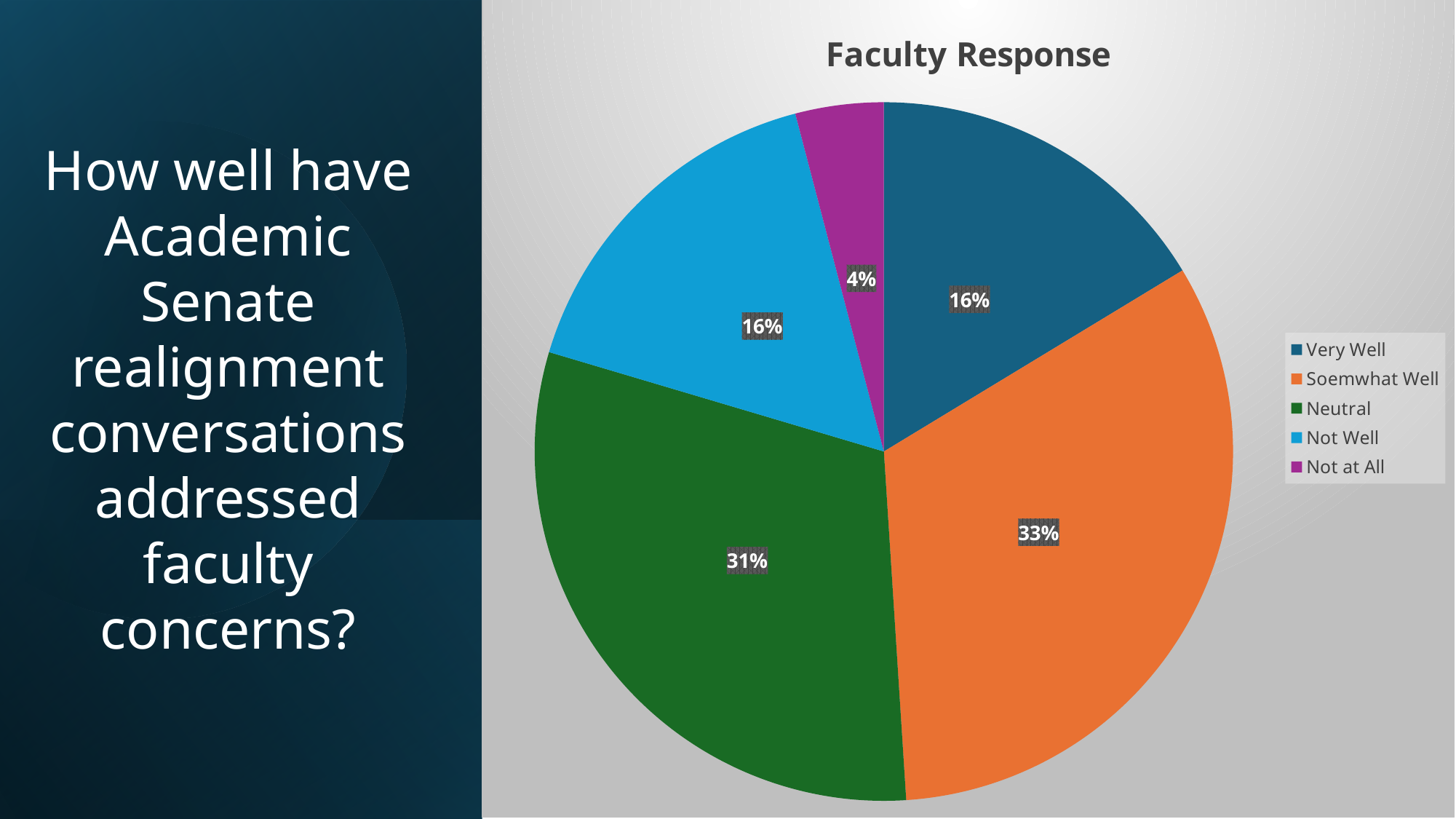
What percentage of faculty responded "Neutral"? 31% Which response category has the largest share of the pie? Soemwhat Well What is the title of the chart? Faculty Response What percentage of faculty responded "Very Well"? 16% Which is larger, the share for "Neutral" or the share for "Not Well"? Neutral How many response categories does the pie chart show? 5 What percentage of faculty responded "Not at All"? 4% What kind of chart is shown on the slide? Pie chart What colour is the "Neutral" slice? Green What is the difference in percentage points between "Somewhat Well" and "Not at All"? 29 What percentage of faculty responded "Somewhat Well"? 33% Which response category has the smallest share of the pie? Not at All